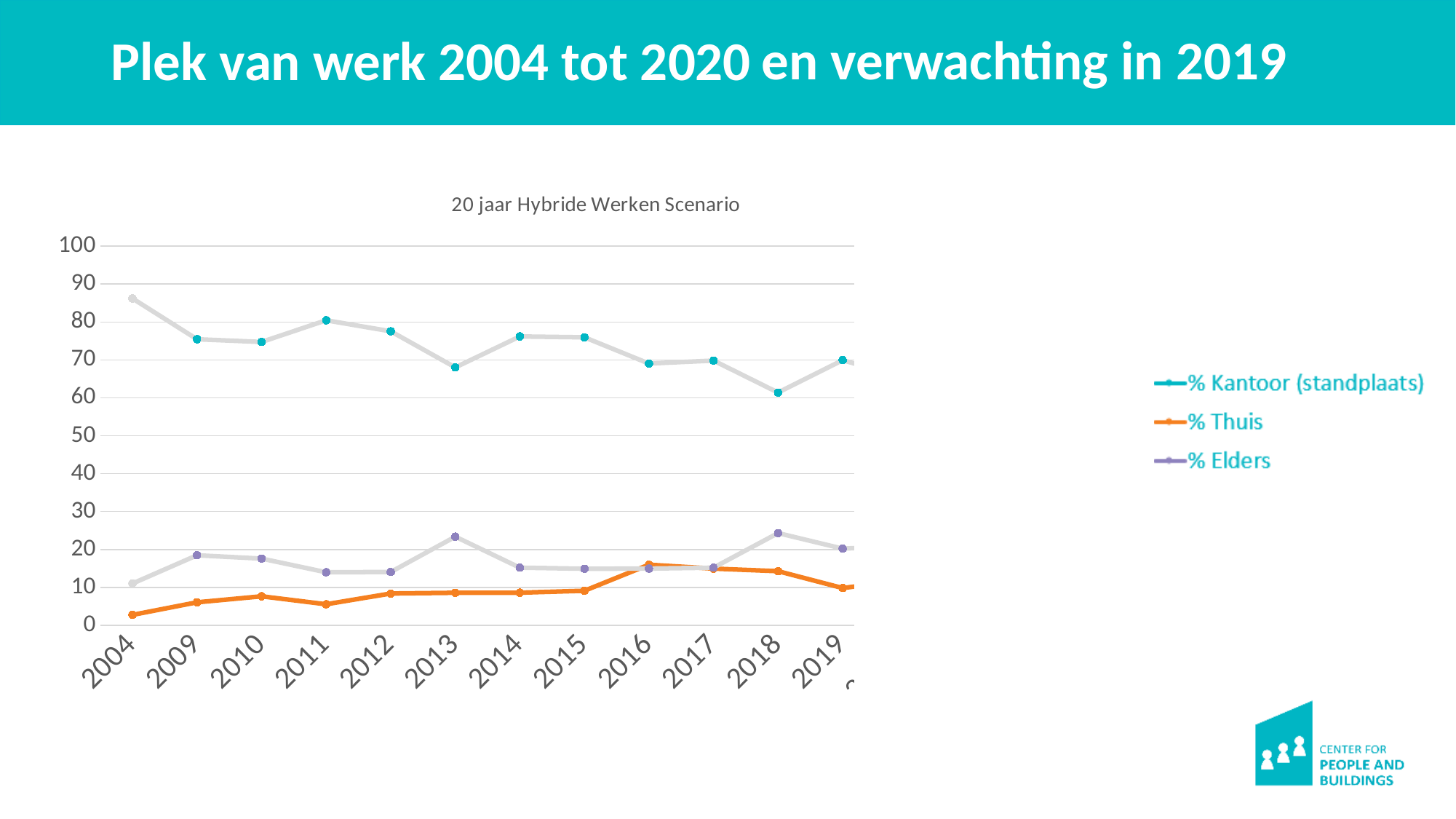
In which year is the value for % Thuis lowest? 2004 How many series does the legend list? 3 Is the value for % Kantoor (standplaats) in 2004 greater or less than 80? greater Is the value for % Thuis in 2004 greater or less than 10? less In which year is the value for % Kantoor (standplaats) lowest? 2018 Is the value for % Kantoor (standplaats) in 2018 greater or less than 70? less Does the % Kantoor (standplaats) series generally rise or fall from 2004 to 2018? fall What is the title of the chart? 20 jaar Hybride Werken Scenario Which is larger in 2018, % Elders or % Thuis? % Elders In which year is the value for % Kantoor (standplaats) highest? 2004 Which colour is used for the % Thuis series? orange What kind of chart is shown on the slide? line chart